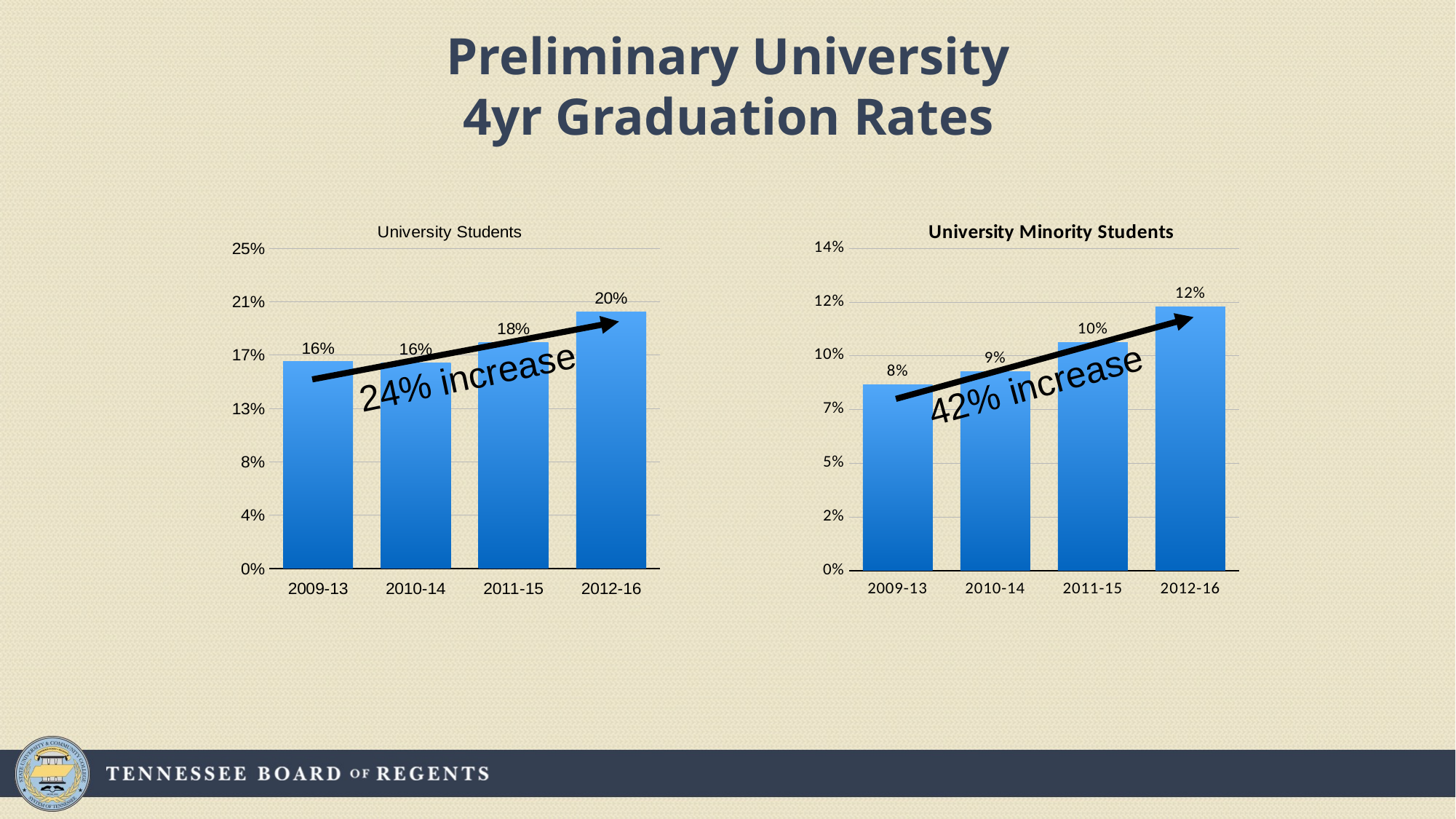
How many periods are shown on the x axis of the University Students chart? 4 In the University Students chart, which period has the highest value? 2012-16 In the University Students chart, what is the value for 2012-16? 20% In the University Minority Students chart, what is the value for 2009-13? 8% In the University Minority Students chart, what is the value for 2011-15? 10% In the University Minority Students chart, which period has the highest value? 2012-16 In the University Students chart, is the value for 2011-15 larger or smaller than the value for 2012-16? smaller In the University Minority Students chart, do the values rise or fall from 2009-13 to 2012-16? rise What kind of chart is the University Minority Students chart? bar chart In the University Minority Students chart, which period has the lowest value? 2009-13 In the University Minority Students chart, what is the difference between the 2012-16 and 2009-13 values? 4% In the University Students chart, what is the value for 2011-15? 18%